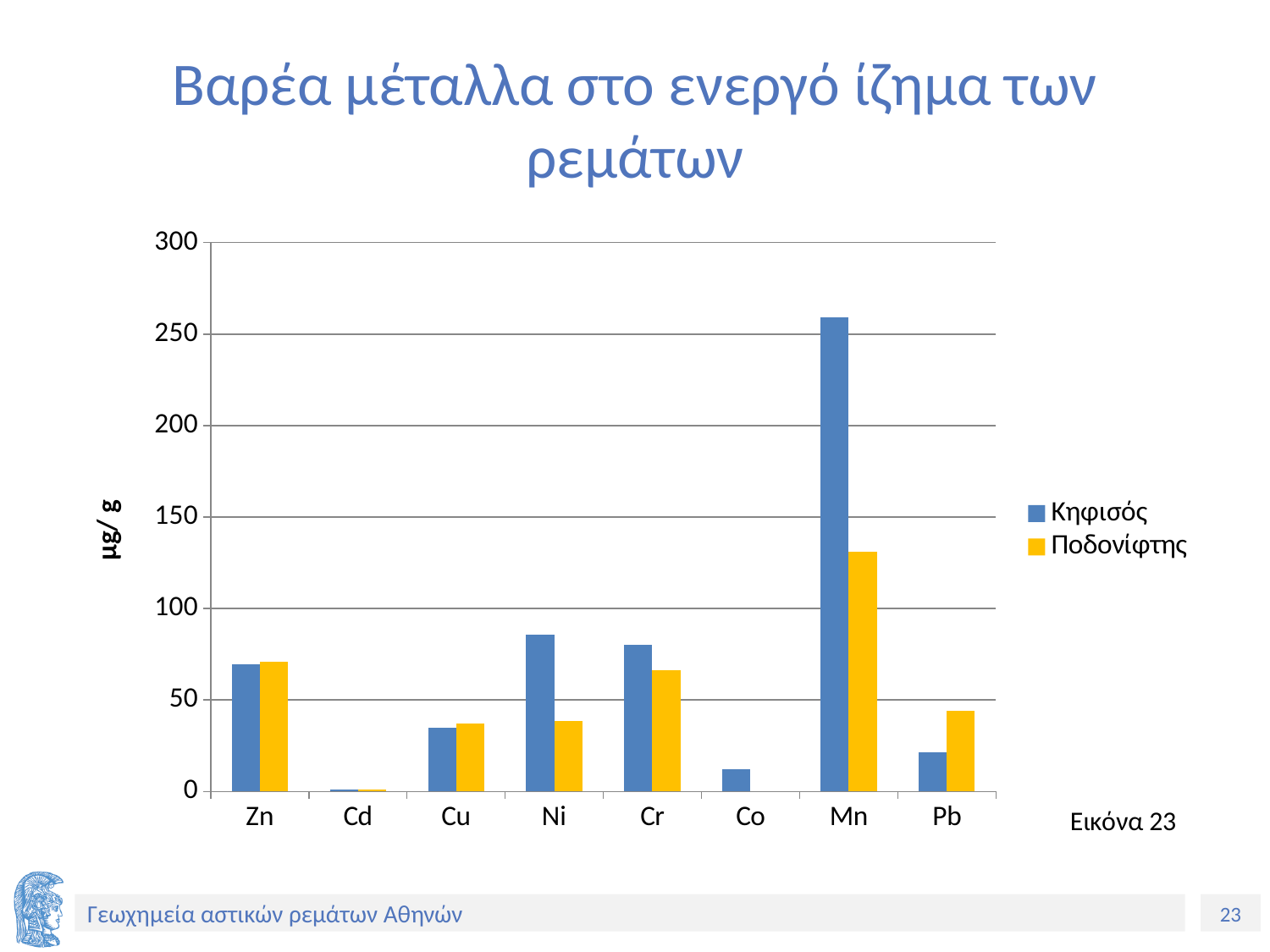
Which metal has the lowest value for Κηφισός? Cd For Pb, which series has the larger value, Κηφισός or Ποδονίφτης? Ποδονίφτης Is the Ποδονίφτης value for Mn greater or less than 150? less Which metal has the highest value for Ποδονίφτης? Mn What kind of chart is shown on the slide? bar chart For Ni, which series has the larger value, Κηφισός or Ποδονίφτης? Κηφισός Which metal has the highest value for Κηφισός? Mn How many series does the legend list? 2 Is the Κηφισός value for Mn greater or less than 250? greater What unit is shown on the y axis label? μg/g Is the Κηφισός value for Ni greater or less than 50? greater How many metal categories are shown on the x axis? 8